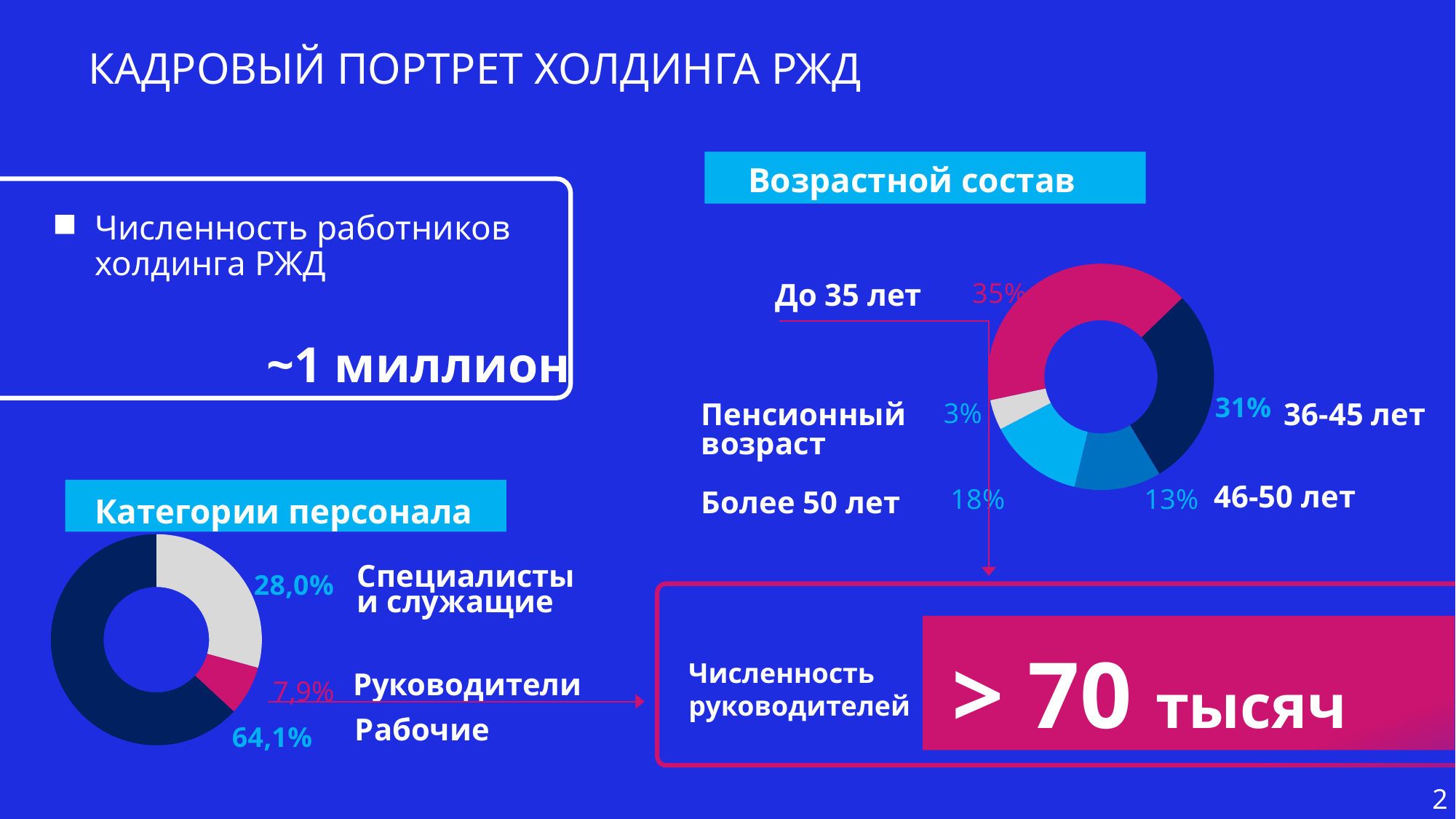
In the 'Возрастной состав' chart, what is the difference between the shares for 'Более 50 лет' and '46-50 лет'? 5% In the 'Возрастной состав' chart, which age group has the smallest share? Пенсионный возраст In the 'Категории персонала' chart, which is larger: 'Специалисты и служащие' or 'Руководители'? Специалисты и служащие In the 'Возрастной состав' chart, which age group has the largest share? До 35 лет In the 'Категории персонала' chart, what share is shown for 'Рабочие'? 64,1% What type of chart is used for 'Категории персонала'? Donut (pie) chart In the 'Возрастной состав' chart, what share is shown for '46-50 лет'? 13% In the 'Категории персонала' chart, what share is shown for 'Руководители'? 7,9% In the 'Возрастной состав' chart, what share is shown for 'До 35 лет'? 35% In the 'Категории персонала' chart, which category has the largest share? Рабочие In the 'Возрастной состав' chart, how many age groups are shown? 5 In the 'Возрастной состав' chart, what share is shown for 'Пенсионный возраст'? 3%